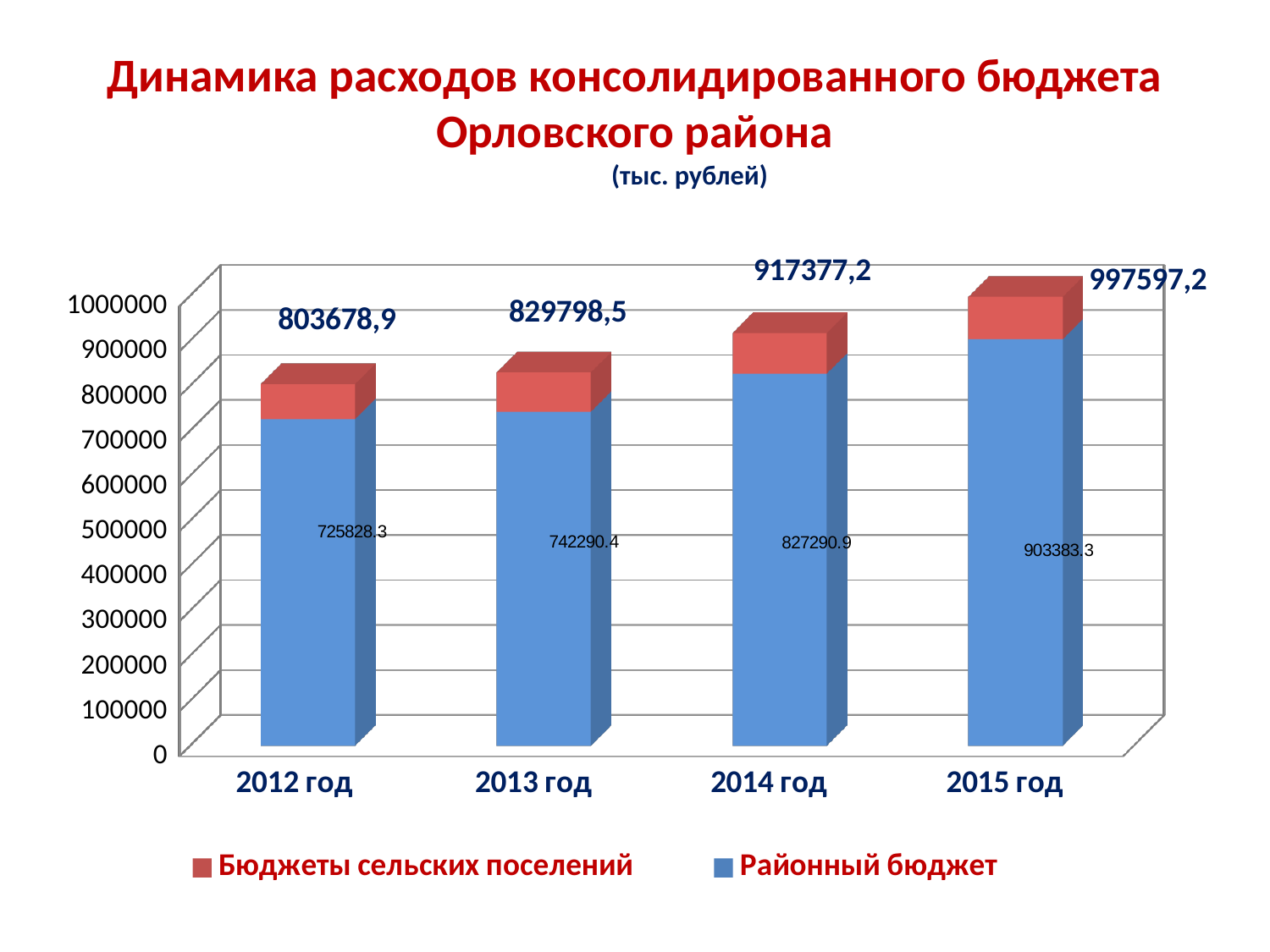
What is the value of Районный бюджет for 2014 год? 827290.9 Do the totals shown above the bars rise or fall from 2012 год to 2015 год? rise Which year has the lowest value for Районный бюджет? 2012 год What is the total consolidated budget expenditure shown above the bar for 2015 год? 997597,2 Which is larger, the Районный бюджет value for 2013 год or for 2014 год? 2014 год What is the value of Районный бюджет for 2012 год? 725828.3 How many series does the legend list? 2 What is the difference between the Районный бюджет values for 2015 год and 2012 год? 177555.0 How many years are shown on the x axis? 4 What is the difference between the totals shown above the bars for 2014 год and 2013 год? 87578,7 Which year has the highest total shown above its bar? 2015 год Is the Районный бюджет value for 2012 год greater or less than 800000? less